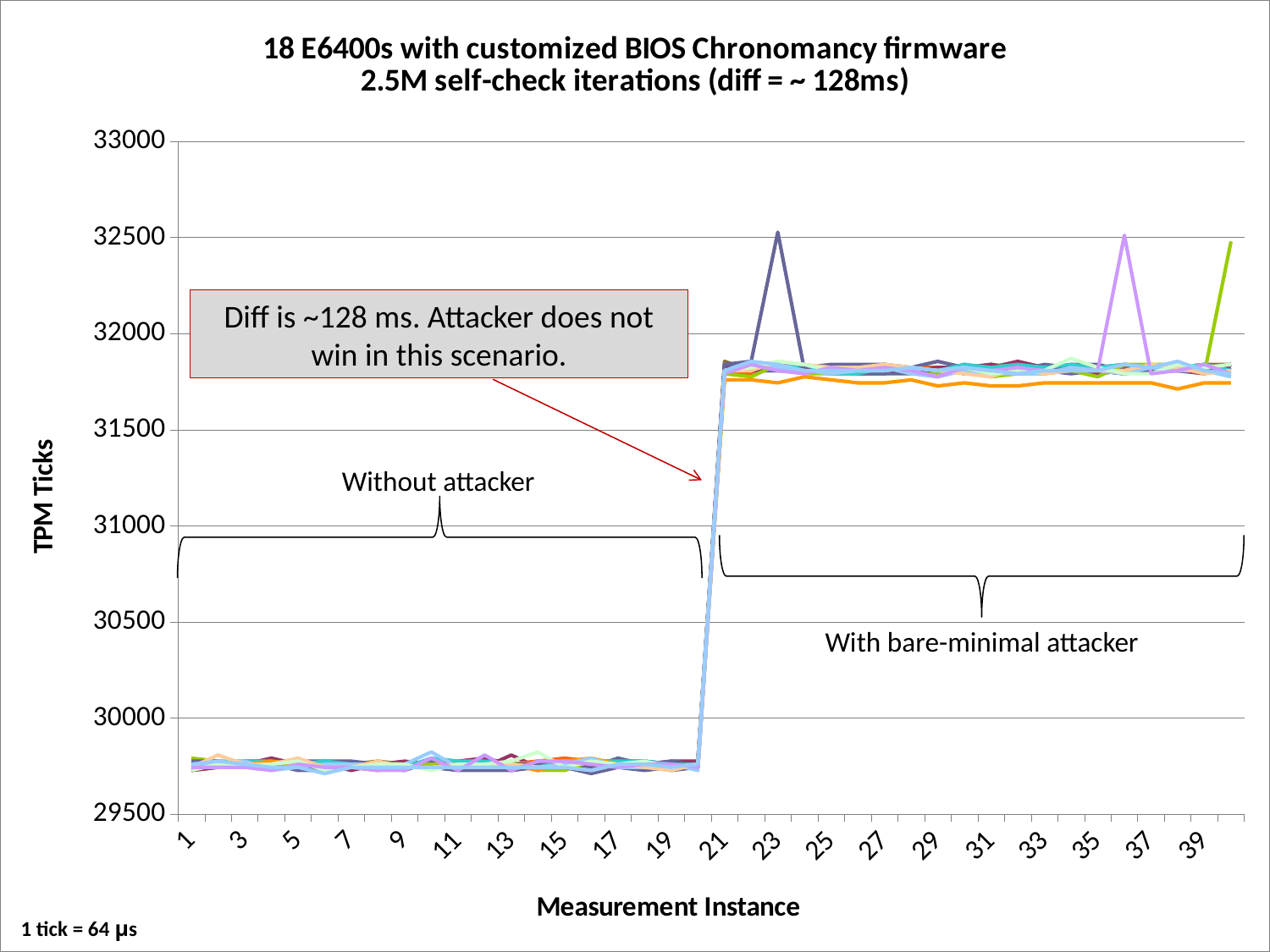
Do the plotted values rise or fall when moving from measurement instance 20 to measurement instance 21? rise Is the value for measurement instance 1 greater or less than 29500? greater Are the values at measurement instance 25 larger or smaller than the values at measurement instance 15? larger Is the value for measurement instance 30 greater or less than 31500? greater What is the title of the chart? 18 E6400s with customized BIOS Chronomancy firmware 2.5M self-check iterations (diff = ~ 128ms) What kind of chart is shown on the slide? Line chart Is the highest value plotted at measurement instance 23 greater or less than 32000? greater What is the label of the y axis? TPM Ticks Overall, do the values rise or fall along the x axis from instance 1 to instance 40? rise